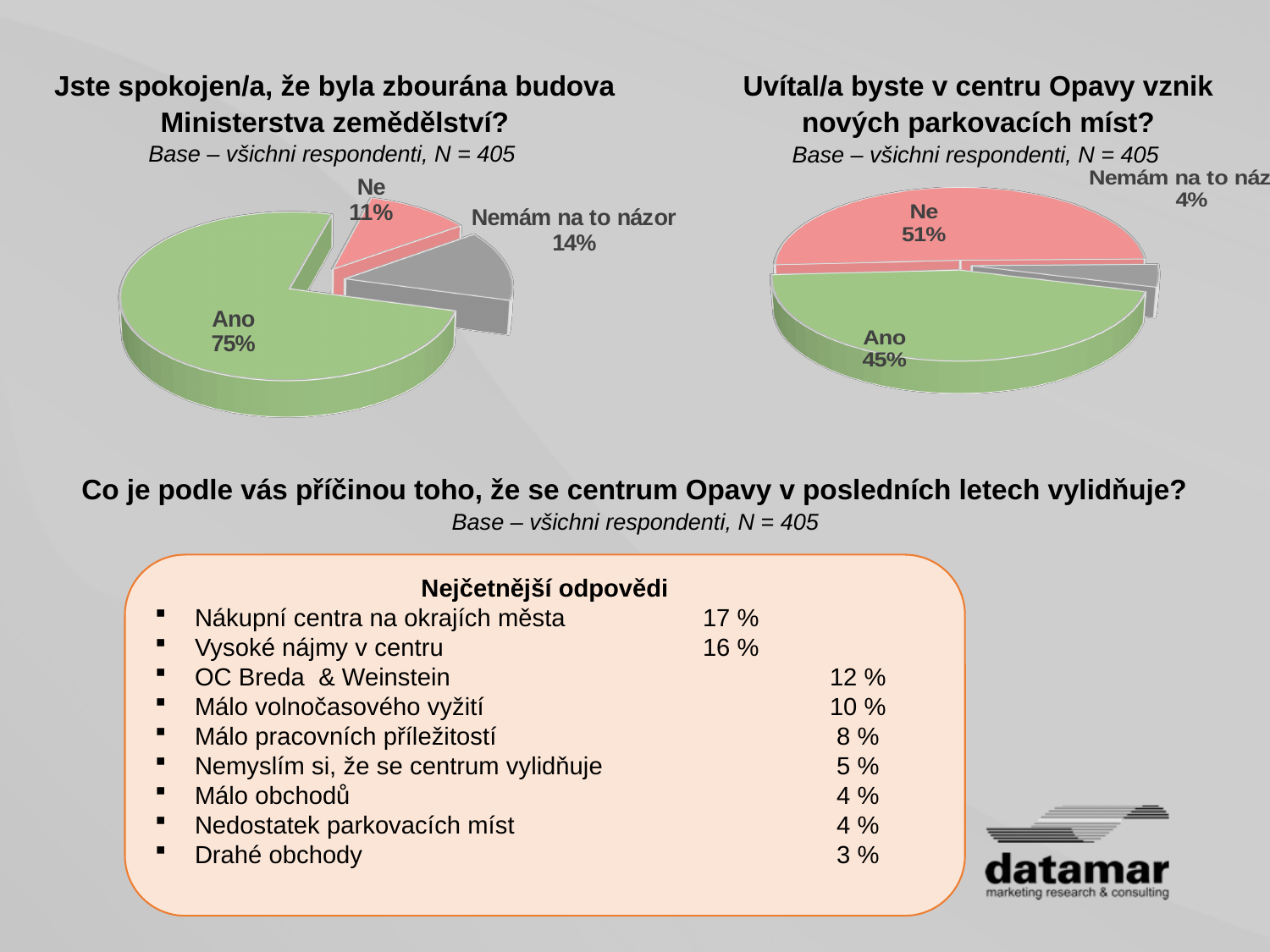
In the right pie chart (Uvítal/a byste v centru Opavy vznik nových parkovacích míst?), what share does the grey slice represent? 4% What type of chart is used for the two questions at the top of the slide? Pie chart In the left pie chart (Jste spokojen/a, že byla zbourána budova Ministerstva zemědělství?), what share of respondents answered Nemám na to názor? 14% In the left pie chart (Jste spokojen/a, že byla zbourána budova Ministerstva zemědělství?), which answer has the smallest share? Ne In the right pie chart (Uvítal/a byste v centru Opavy vznik nových parkovacích míst?), how many percentage points larger is the Ne share than the Ano share? 6 percentage points In the right pie chart (Uvítal/a byste v centru Opavy vznik nových parkovacích míst?), what share of respondents answered Ano? 45% In the left pie chart (Jste spokojen/a, že byla zbourána budova Ministerstva zemědělství?), what share of respondents answered Ano? 75% In the right pie chart (Uvítal/a byste v centru Opavy vznik nových parkovacích míst?), which is larger, the Ano share or the Ne share? Ne In the left pie chart (Jste spokojen/a, že byla zbourána budova Ministerstva zemědělství?), which answer has the largest share? Ano In the left pie chart (Jste spokojen/a, že byla zbourána budova Ministerstva zemědělství?), how many percentage points larger is the Ano share than the Ne share? 64 percentage points In the left pie chart (Jste spokojen/a, že byla zbourána budova Ministerstva zemědělství?), what share of respondents answered Ne? 11% In the right pie chart (Uvítal/a byste v centru Opavy vznik nových parkovacích míst?), what share of respondents answered Ne? 51%